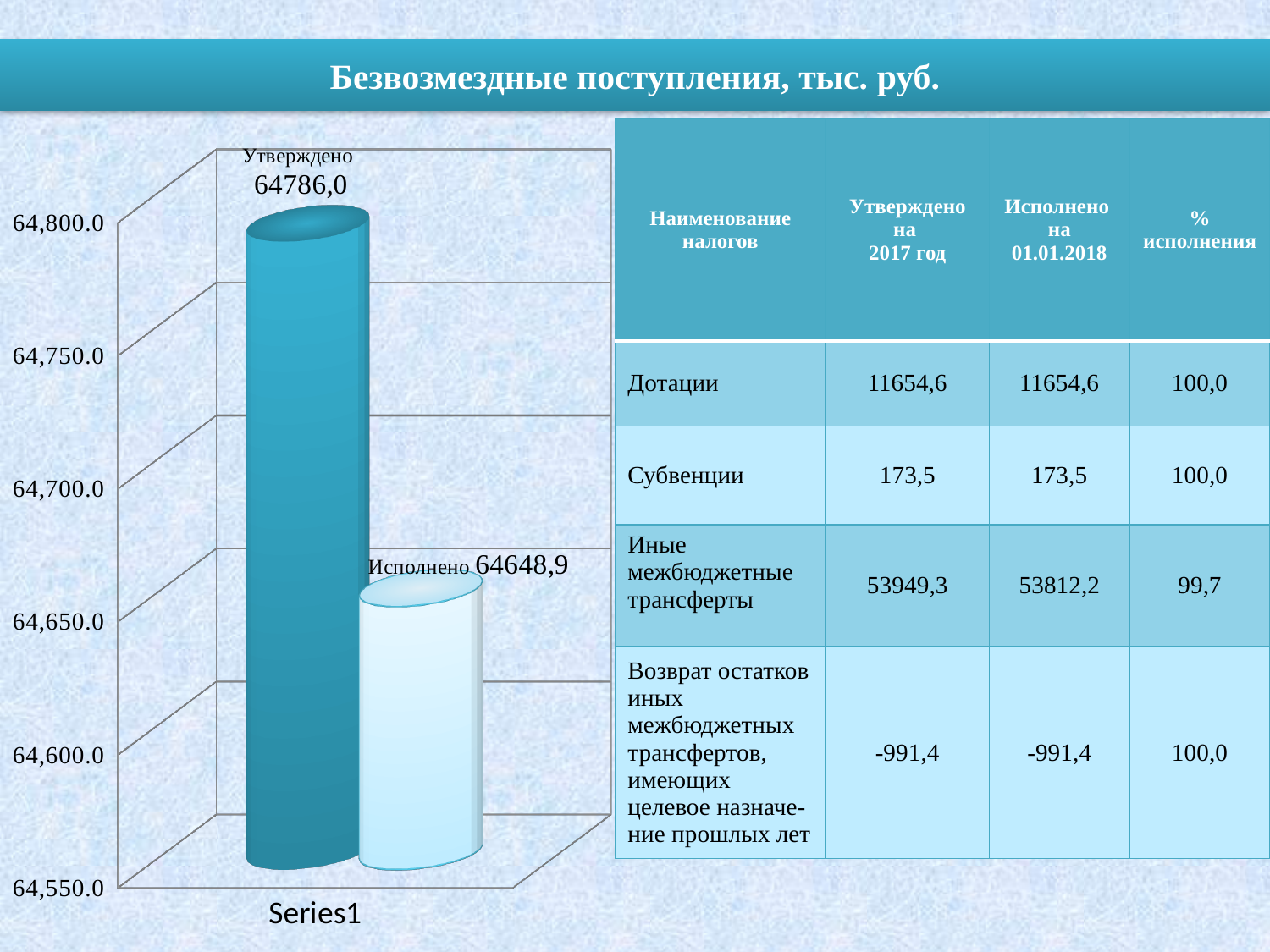
How many bars are plotted in the chart? 2 What label appears on the horizontal axis below the bars? Series1 Is the value for Утверждено greater or less than 64,750.0? greater What value is shown for the Утверждено bar? 64786,0 What type of chart is shown on the slide? bar chart Which bar has the lowest value? Исполнено What value is shown for the Исполнено bar? 64648,9 Which bar is higher, Утверждено or Исполнено? Утверждено Is the value for Исполнено greater or less than the Утверждено value? less What is the title shown above the chart on the slide? Безвозмездные поступления, тыс. руб. What is the difference between the Утверждено and Исполнено values? 137,1 Is the value for Исполнено greater or less than 64,700.0? less